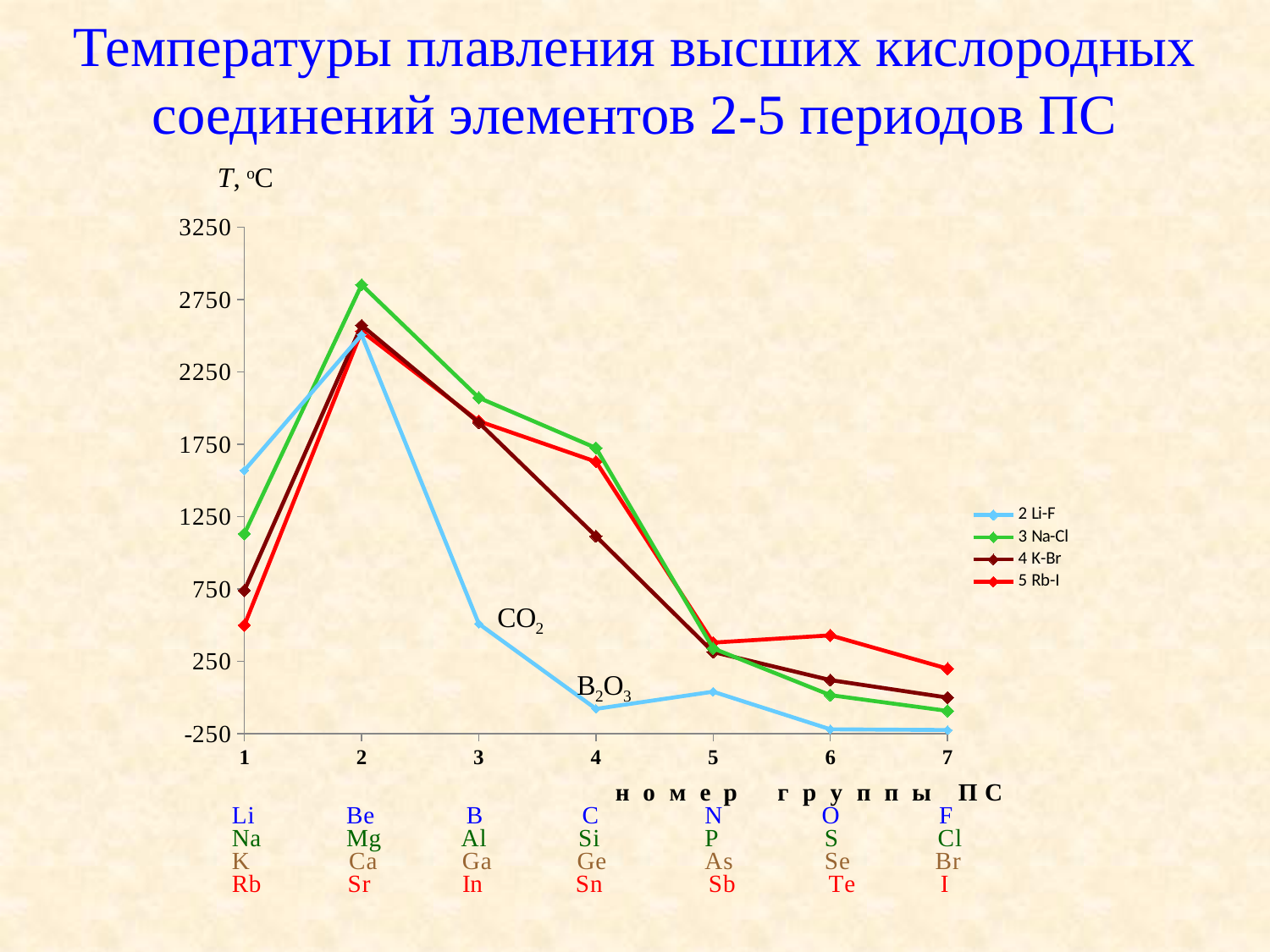
Is the value for 3 Na-Cl at group 2 greater or less than 2750? greater At which group number does the 3 Na-Cl series reach its highest value? 2 How many series does the legend list? 4 Which series has the highest value at group 2? 3 Na-Cl How many group numbers are plotted along the x axis? 7 From group 2 to group 7, do the values of the 3 Na-Cl series rise or fall? fall Which series has the lowest value at group 1? 5 Rb-I What kind of chart is shown on the slide? line chart At group 6, which series has the larger value, 5 Rb-I or 2 Li-F? 5 Rb-I Is the value for 2 Li-F at group 1 greater or less than 1250? greater At group 1, which series has the larger value, 2 Li-F or 5 Rb-I? 2 Li-F Is the value for 2 Li-F at group 3 greater or less than 750? less